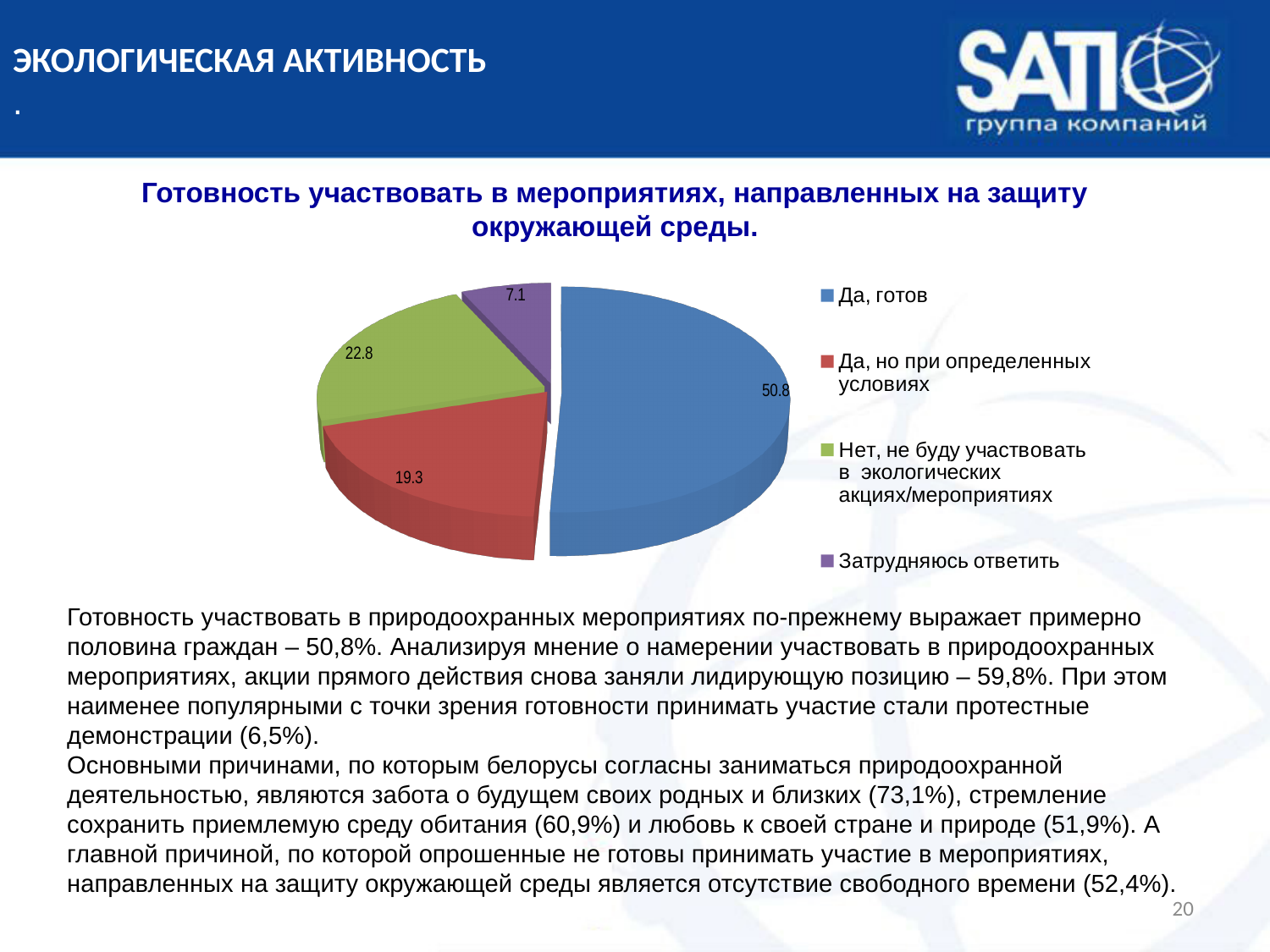
What is the value for "Затрудняюсь ответить"? 7.1 Which category has the largest slice of the pie? Да, готов What is the value for "Нет, не буду участвовать в экологических акциях/мероприятиях"? 22.8 What colour is the slice for "Да, готов"? Blue What is the title of the chart? Готовность участвовать в мероприятиях, направленных на защиту окружающей среды. What is the value for "Да, но при определенных условиях"? 19.3 What kind of chart is shown on the slide? Pie chart What is the difference between the values for "Да, готов" and "Затрудняюсь ответить"? 43.7 How many categories does the pie chart have? 4 What is the value for "Да, готов"? 50.8 Which category has the smallest slice of the pie? Затрудняюсь ответить Which is larger: the value for "Нет, не буду участвовать в экологических акциях/мероприятиях" or the value for "Да, но при определенных условиях"? Нет, не буду участвовать в экологических акциях/мероприятиях